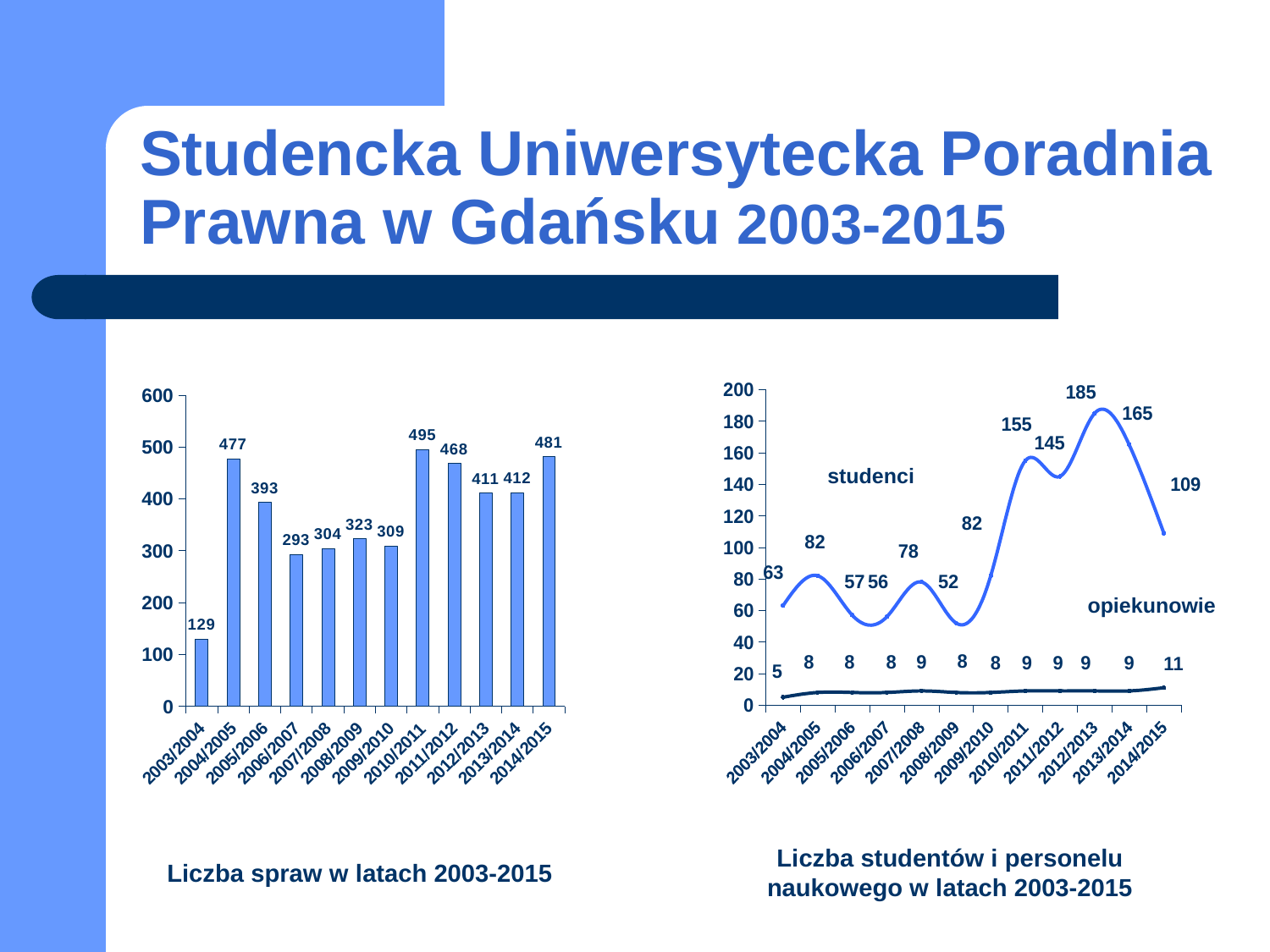
In the chart titled 'Liczba studentów i personelu naukowego w latach 2003-2015', which year has the lowest value for studenci? 2008/2009 In the chart titled 'Liczba spraw w latach 2003-2015', which year has the lowest value? 2003/2004 In the chart titled 'Liczba spraw w latach 2003-2015', what is the difference between the values for 2004/2005 and 2005/2006? 84 In the chart titled 'Liczba studentów i personelu naukowego w latach 2003-2015', what is the difference between the studenci values for 2012/2013 and 2014/2015? 76 In the chart titled 'Liczba spraw w latach 2003-2015', how many years are shown on the x axis? 12 In the chart titled 'Liczba studentów i personelu naukowego w latach 2003-2015', what is the value for opiekunowie in 2014/2015? 11 What kind of chart is the one titled 'Liczba studentów i personelu naukowego w latach 2003-2015'? line chart What kind of chart is the one titled 'Liczba spraw w latach 2003-2015'? bar chart In the chart titled 'Liczba spraw w latach 2003-2015', which year has the highest value? 2010/2011 In the chart titled 'Liczba studentów i personelu naukowego w latach 2003-2015', is the value for studenci in 2010/2011 larger than the value in 2011/2012? Yes In the chart titled 'Liczba spraw w latach 2003-2015', what is the value for 2010/2011? 495 In the chart titled 'Liczba studentów i personelu naukowego w latach 2003-2015', what is the value for studenci in 2012/2013? 185